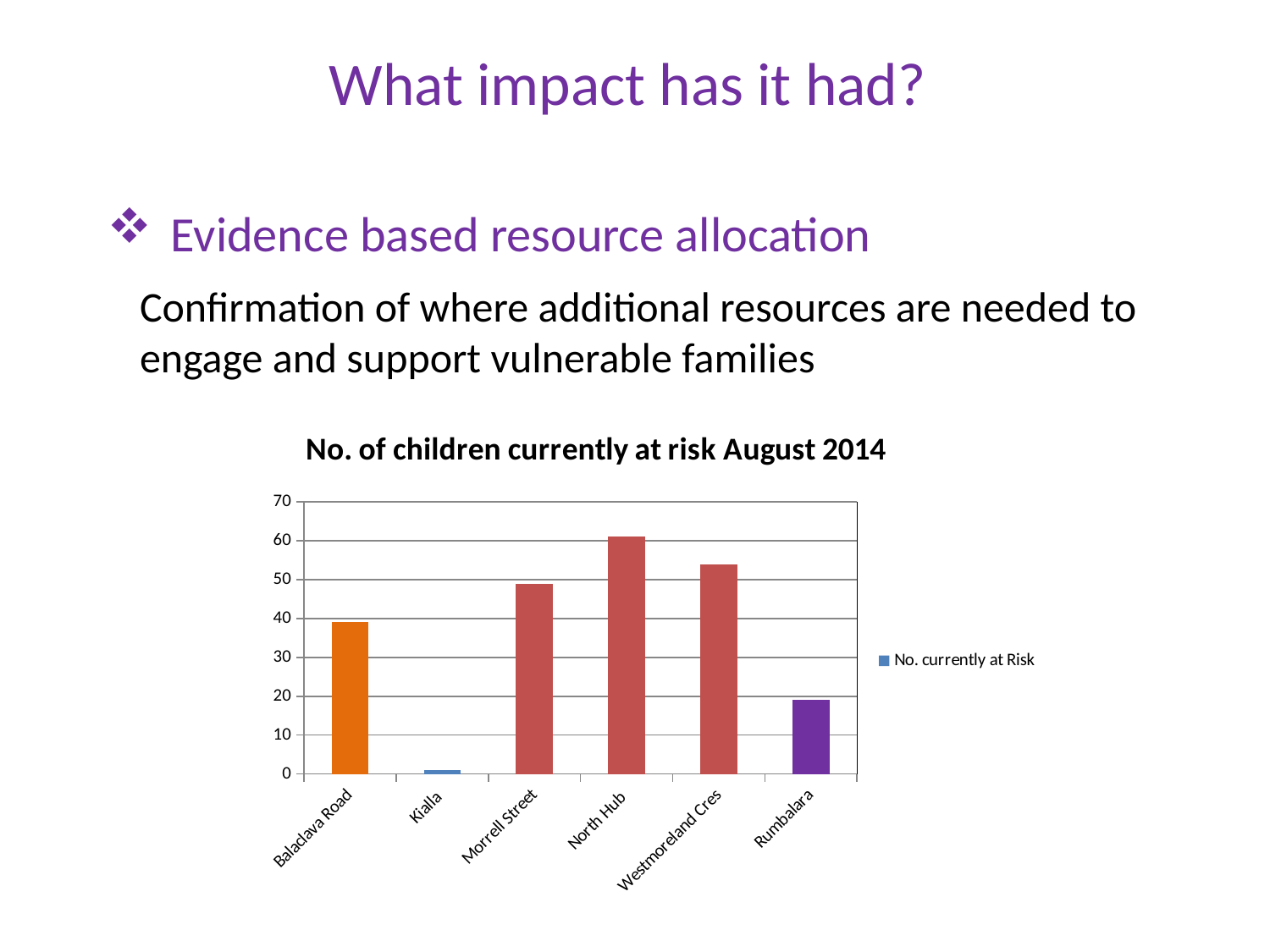
Is the value for Balaclava Road greater or less than 30? greater What is the title of the chart? No. of children currently at risk August 2014 Is the value for Rumbalara greater or less than 10? greater Which category has the lowest number of children currently at risk? Kialla Which has a higher value, Balaclava Road or Rumbalara? Balaclava Road Which category has the highest number of children currently at risk? North Hub Which has a higher value, Morrell Street or Westmoreland Cres? Westmoreland Cres What is the name of the series shown in the legend? No. currently at Risk How many series does the chart legend list? 1 What type of chart is shown on the slide? bar chart How many categories are shown on the x axis of the chart? 6 Is the value for Kialla greater or less than 10? less